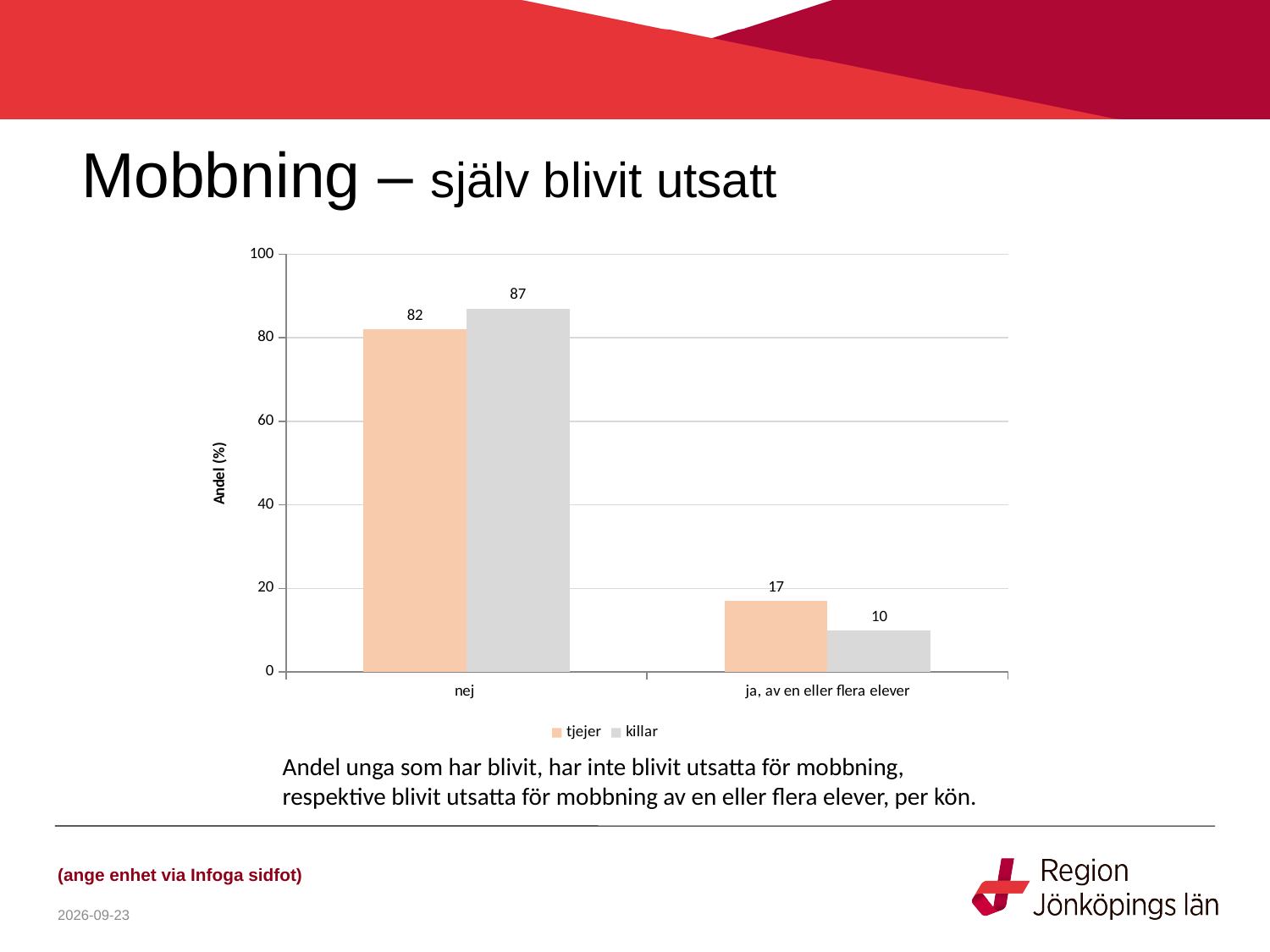
How many series does the legend list? 2 How many categories are shown on the x axis? 2 Which series has the higher value in the category "ja, av en eller flera elever"? tjejer What is the value for tjejer in the category "ja, av en eller flera elever"? 17 Which series has the higher value in the category "nej"? killar What is the value for killar in the category "ja, av en eller flera elever"? 10 What is the label of the y axis? Andel (%) What kind of chart is shown on the slide? Bar chart What is the value for killar in the category "nej"? 87 What is the value for tjejer in the category "nej"? 82 What is the difference between tjejer and killar in the category "ja, av en eller flera elever"? 7 What is the difference between killar and tjejer in the category "nej"? 5